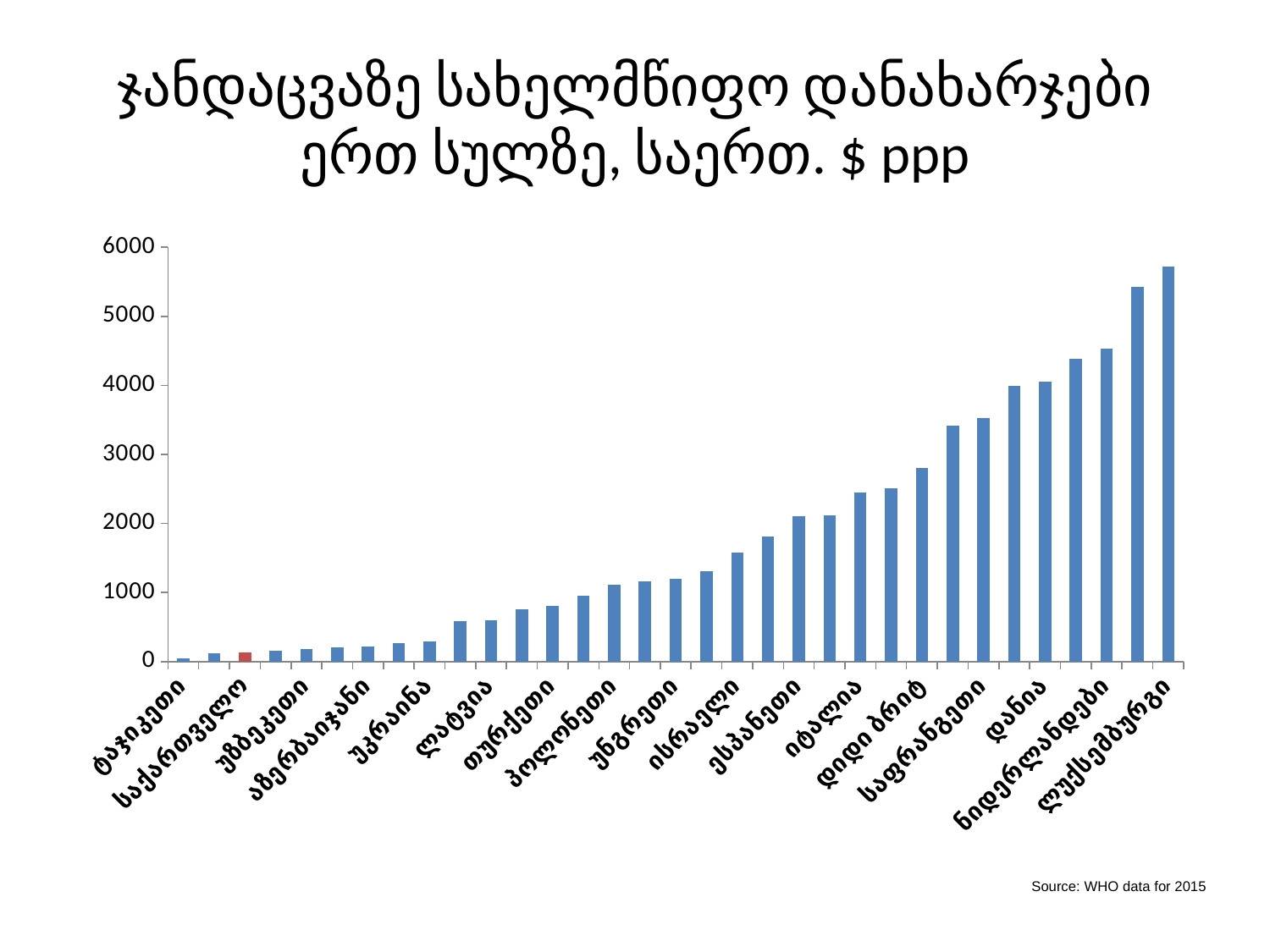
Is the value for თურქეთი greater or less than 1000? less Which country has the lowest value on the chart? ტაჯიკეთი Is the value for ლუქსემბურგი greater or less than 5000? greater Which has a larger value, ლუქსემბურგი or ნიდერლანდები? ლუქსემბურგი Is the value for დიდი ბრიტ. greater or less than 3000? less Which has a larger value, იტალია or თურქეთი? იტალია Which country has the highest value on the chart? ლუქსემბურგი What kind of chart is shown on the slide? bar chart Which country's bar is coloured red instead of blue? საქართველო Do the values rise or fall from left to right along the x axis? rise